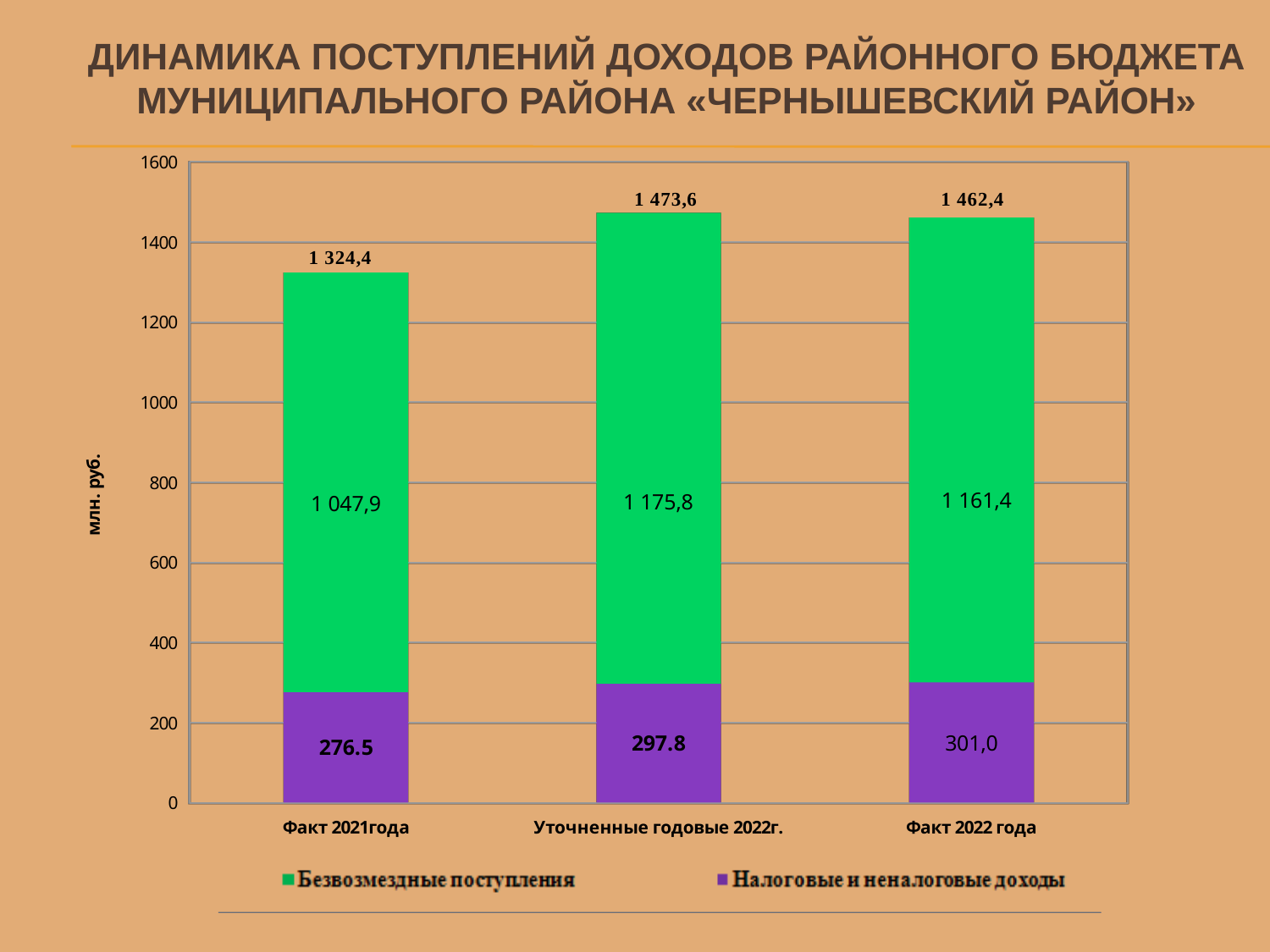
Which colour represents Безвозмездные поступления in the chart? Green How many categories are shown on the x axis? 3 Which category has the lowest value for Безвозмездные поступления? Факт 2021года Which category has the highest total? Уточненные годовые 2022г. How many series does the legend list? 2 What type of chart is shown on the slide? Stacked bar chart What is the value of Налоговые и неналоговые доходы for Факт 2022 года? 301,0 What is the difference between the totals for Уточненные годовые 2022г. and Факт 2022 года? 11,2 What is the value of Безвозмездные поступления for Уточненные годовые 2022г.? 1 175,8 What is the value of Налоговые и неналоговые доходы for Факт 2021года? 276.5 Is the value of Безвозмездные поступления for Факт 2021года greater or less than 1000? greater What is the total of the stacked bar for Факт 2022 года? 1 462,4